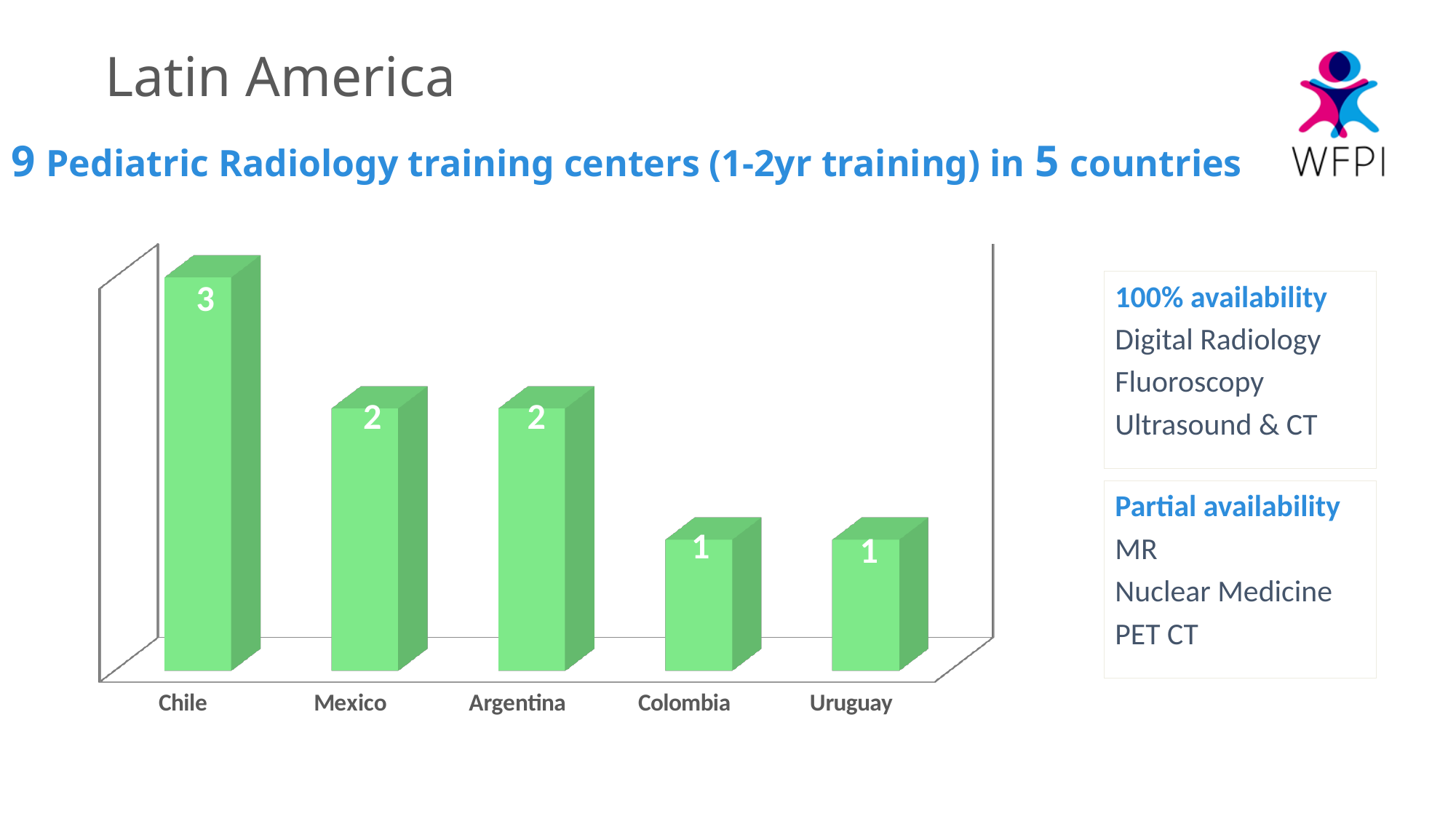
What is the value shown for Mexico? 2 What is the difference between the values for Chile and Uruguay? 2 What kind of chart is shown on the slide? Bar chart Which country has the highest value in the chart? Chile How many countries are shown in the chart? 5 How many pediatric radiology training centers does Chile have according to the chart? 3 What is the total of all the values shown in the chart? 9 What is the value shown for Colombia? 1 What is the difference between the values for Argentina and Colombia? 1 Which is larger, the value for Chile or the value for Mexico? Chile What colour are the bars in the chart? Green Do the values rise or fall from Chile to Uruguay along the x axis? Fall